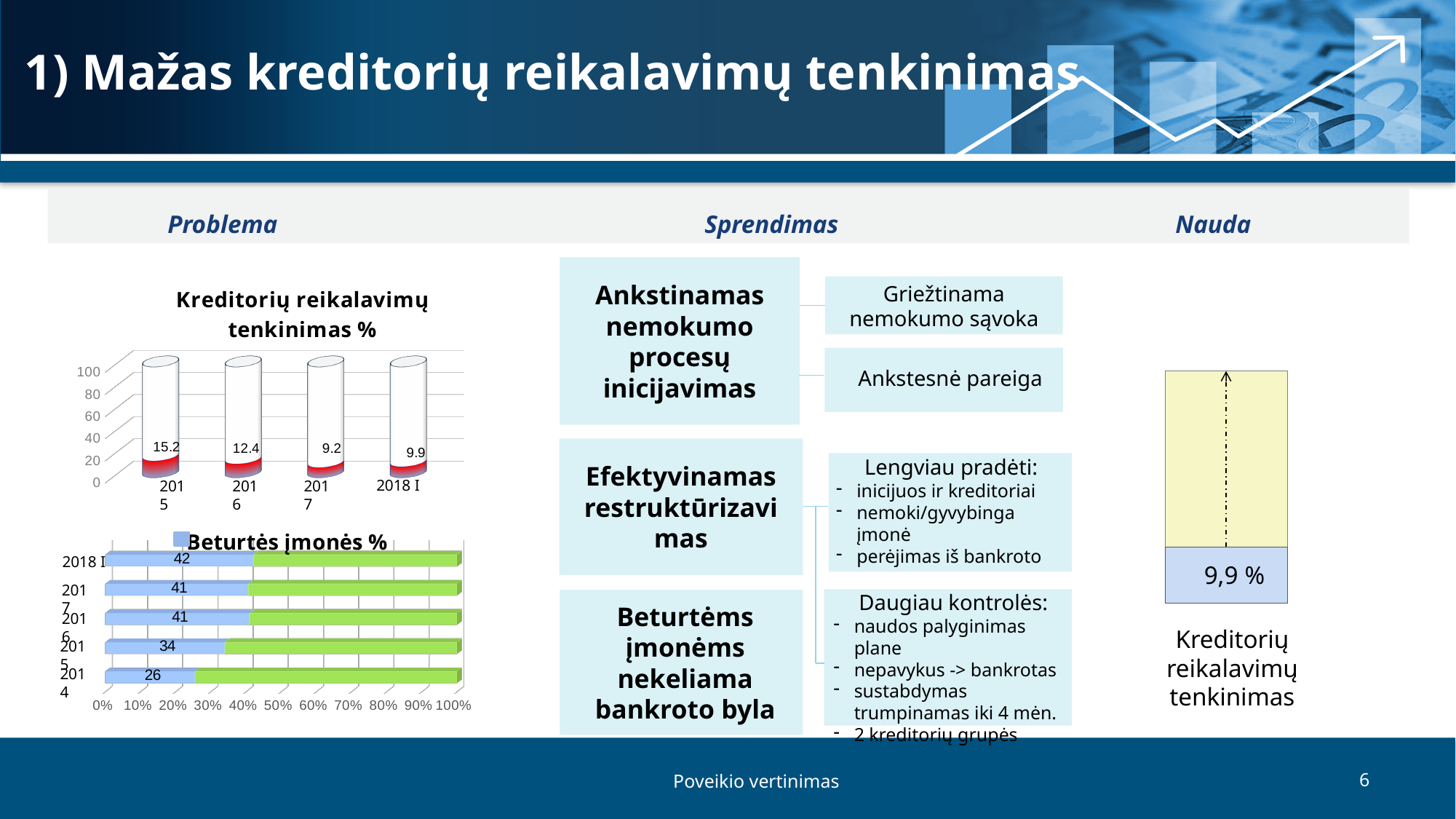
In the chart 'Kreditorių reikalavimų tenkinimas %', which category has the lowest value? 2017 In the chart 'Beturtės įmonės %', what is the blue value for 2018 I? 42 In the chart 'Beturtės įmonės %', what is the difference between the blue values for 2018 I and 2015? 8 In the chart 'Kreditorių reikalavimų tenkinimas %', how many categories are shown on the x axis? 4 In the chart 'Beturtės įmonės %', which category has the lowest blue value? 2014 In the chart 'Kreditorių reikalavimų tenkinimas %', which category has the highest value? 2015 In the chart 'Kreditorių reikalavimų tenkinimas %', what is the difference between the values for 2015 and 2016? 2.8 In the chart 'Kreditorių reikalavimų tenkinimas %', what is the value for 2018 I? 9.9 What kind of chart is 'Beturtės įmonės %'? bar chart In the chart 'Beturtės įmonės %', what is the blue value for 2014? 26 In the chart 'Kreditorių reikalavimų tenkinimas %', do the values generally rise or fall from 2015 to 2017? fall In the chart 'Kreditorių reikalavimų tenkinimas %', what is the value for 2015? 15.2